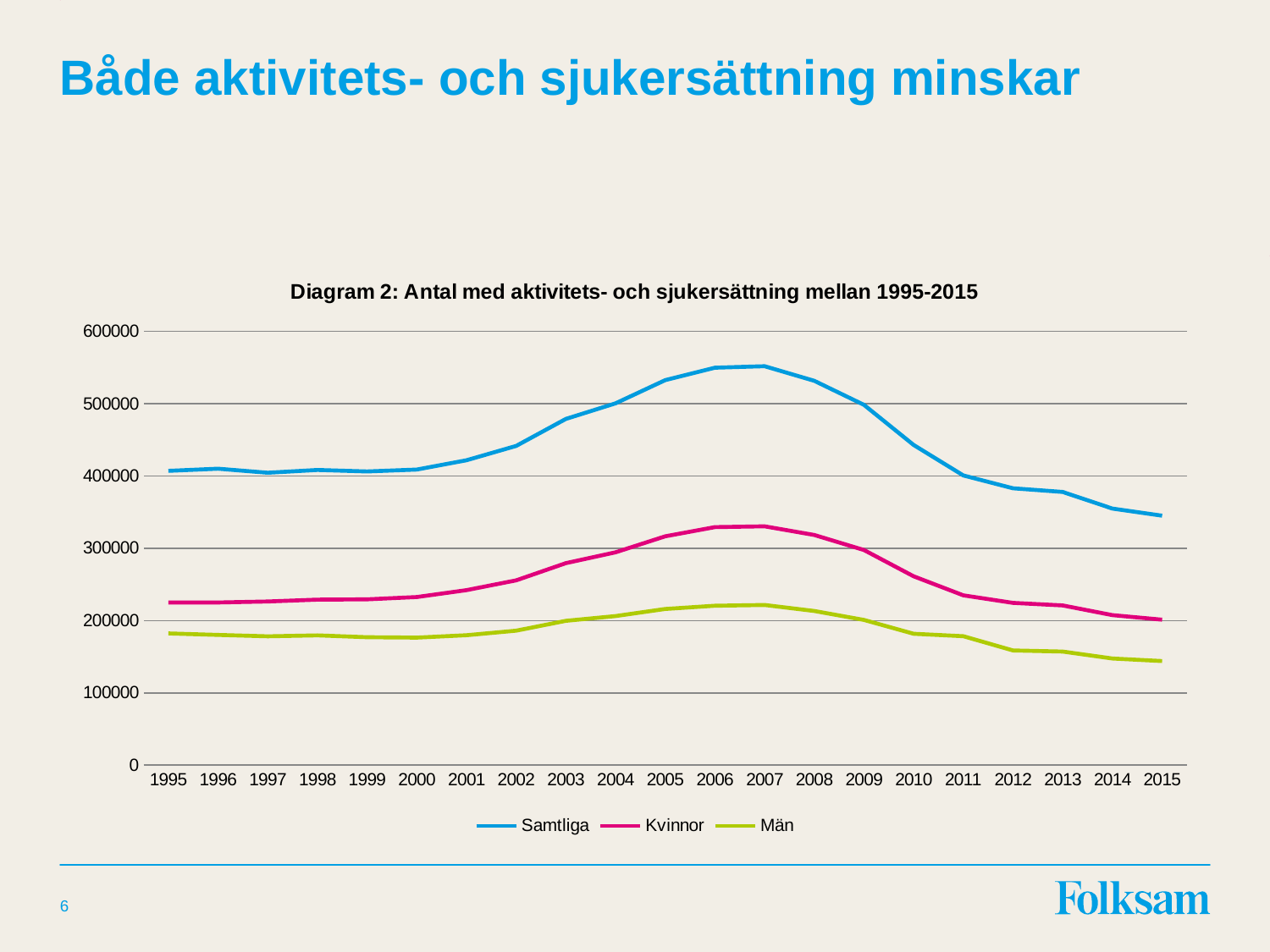
Is the value for Män in 2015 greater or less than 200000? less Which series is drawn in pink? Kvinnor Is the value for Samtliga in 2015 greater or less than 400000? less Do the values for Samtliga rise or fall between 2007 and 2015? Fall In which year is the value for Män lowest? 2015 How many years are shown on the x axis? 21 In 2007, which series has the larger value, Kvinnor or Män? Kvinnor Is the value for Kvinnor in 2007 greater or less than 300000? greater What is the title of the chart? Diagram 2: Antal med aktivitets- och sjukersättning mellan 1995-2015 How many series does the legend list? 3 What kind of chart is shown on the slide? Line chart